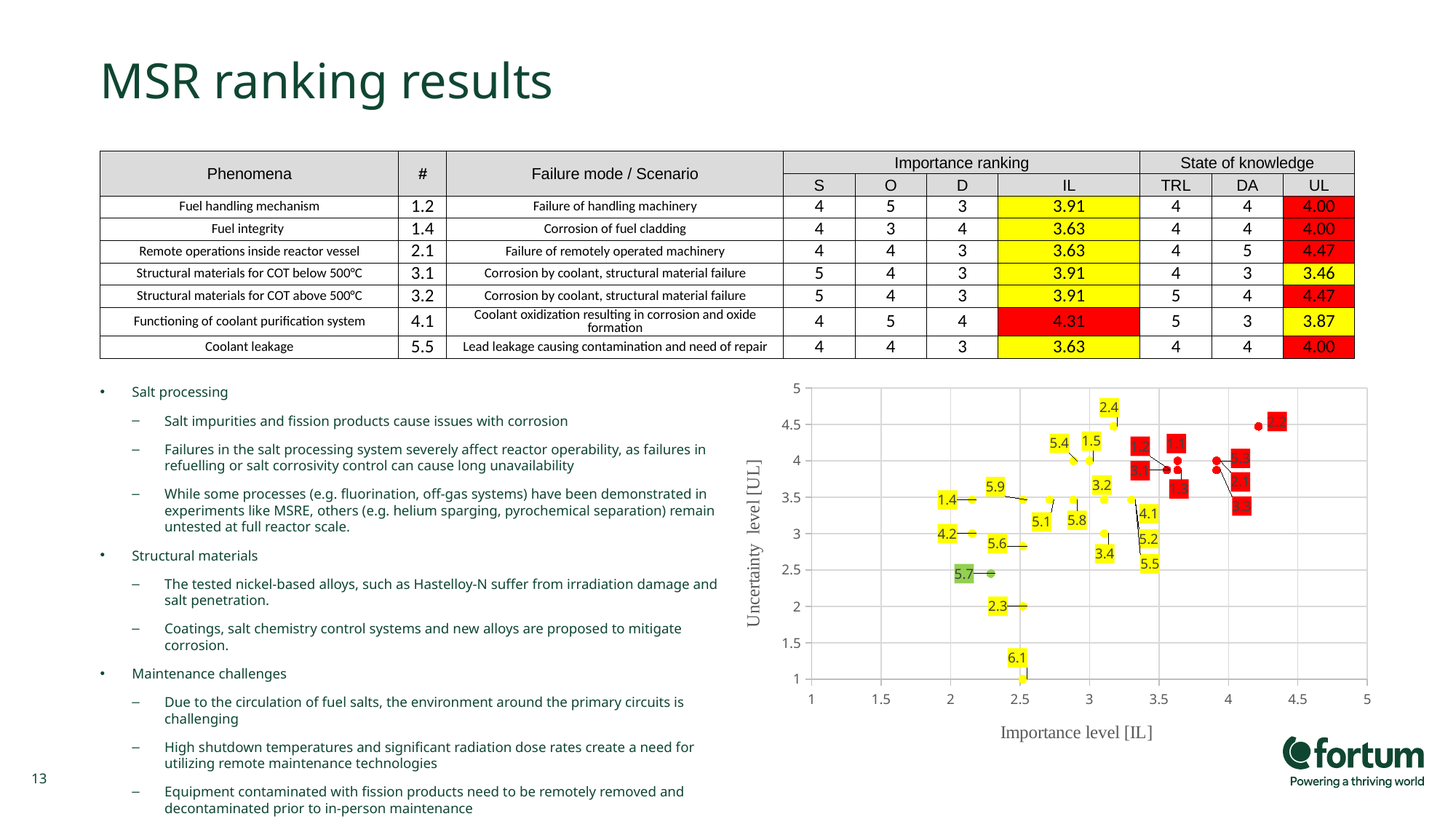
Is the importance level of point 2.2 greater or less than 4? greater What is the title of the x axis of the chart? Importance level [IL] Which point has a higher importance level, 2.2 or 1.4? 2.2 Is the uncertainty level of point 5.7 greater or less than 3? less What is the uncertainty level of point 2.3 in the chart? 2 What is the title of the y axis of the chart? Uncertainty level [UL] What is the uncertainty level of point 6.1 in the chart? 1 Which point has a higher uncertainty level, 2.4 or 6.1? 2.4 Which labelled point has the highest importance level in the chart? 2.2 What kind of chart is shown on the slide? scatter chart Is the importance level of point 1.4 greater or less than 2.5? less Which labelled point has the lowest uncertainty level in the chart? 6.1